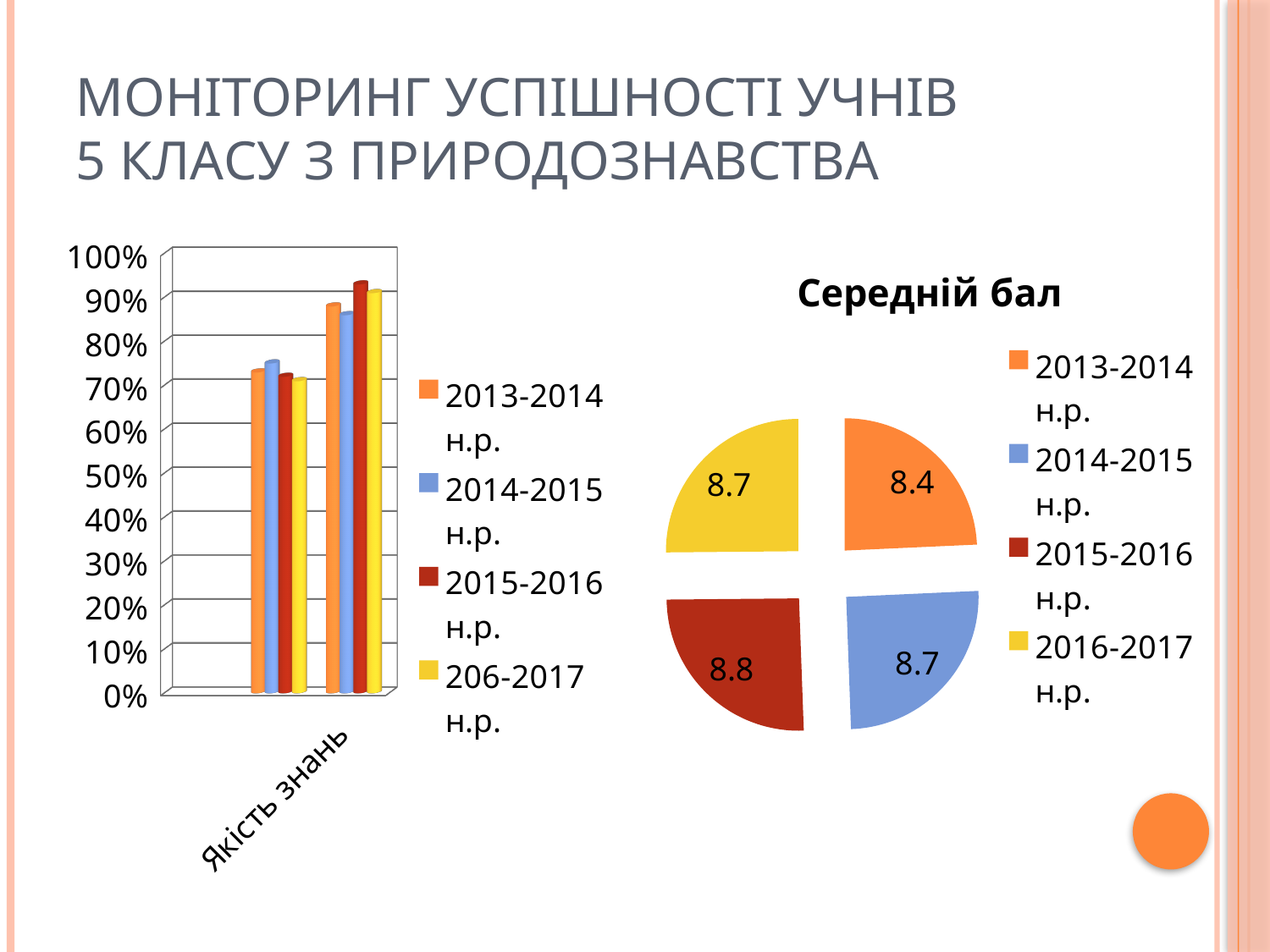
In the "Середній бал" pie chart, which is larger: the value for 2016-2017 н.р. or the value for 2013-2014 н.р.? 2016-2017 н.р. In the "Середній бал" pie chart, what is the value for 2015-2016 н.р.? 8.8 How many series does the legend of the bar chart on the left list? 4 In the "Середній бал" pie chart, what is the difference between the values for 2015-2016 н.р. and 2013-2014 н.р.? 0.4 What kind of chart is the chart on the left of the slide? bar chart In the "Середній бал" pie chart, what is the value for 2014-2015 н.р.? 8.7 In the bar chart on the left, is the value for 2014-2015 н.р. in the "Якість знань" category greater or less than 80%? greater What kind of chart is the chart on the right titled "Середній бал"? pie chart How many slices does the "Середній бал" pie chart have? 4 In the "Середній бал" pie chart, which school year has the highest value? 2015-2016 н.р. In the "Середній бал" pie chart, which school year has the lowest value? 2013-2014 н.р. In the "Середній бал" pie chart, what is the value for 2013-2014 н.р.? 8.4